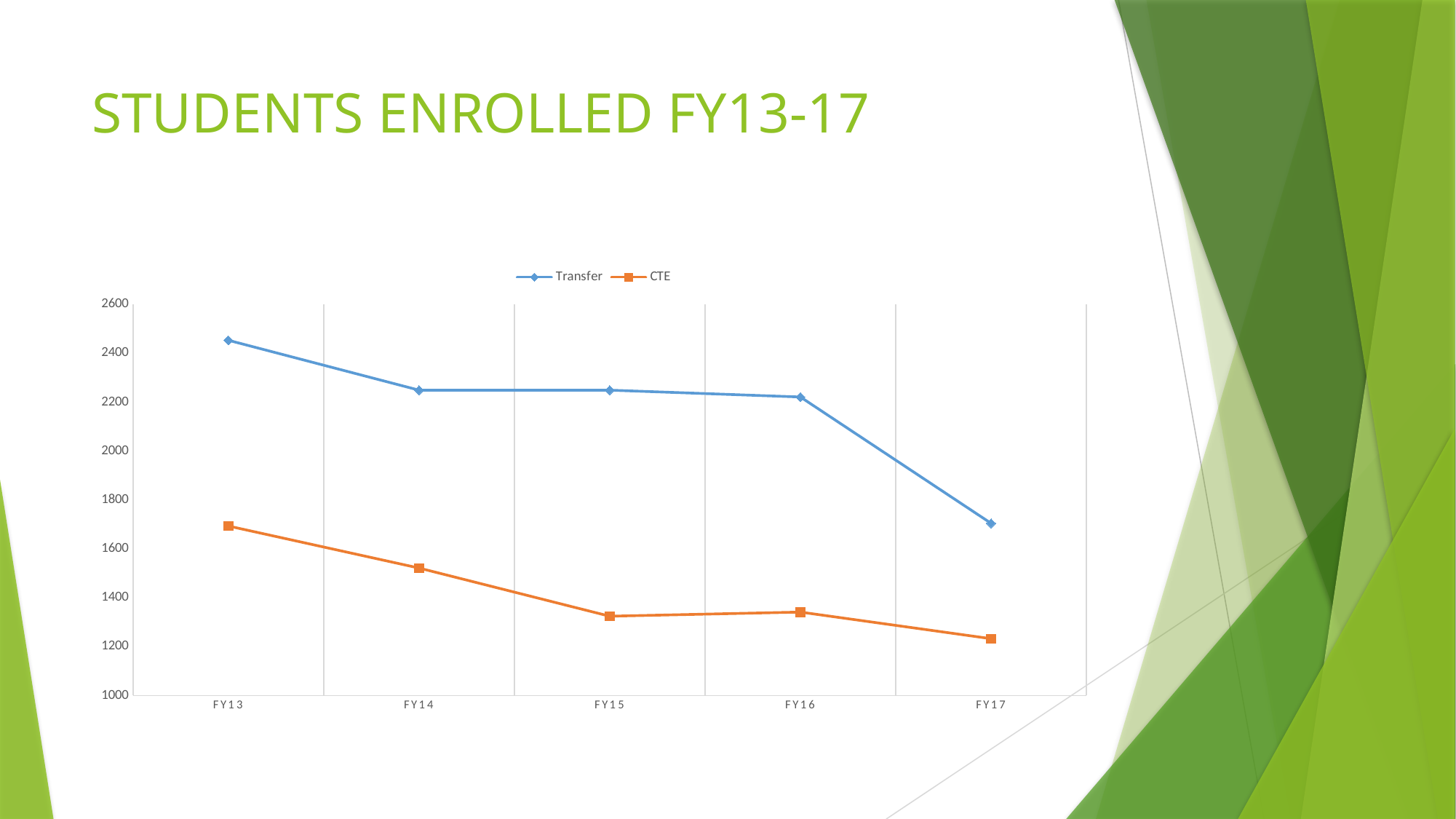
What kind of chart is shown on the slide? line chart In which fiscal year is the Transfer enrollment highest? FY13 Is the Transfer value for FY17 greater or less than 1800? less Is the CTE value for FY13 greater or less than 1600? greater How many fiscal years are plotted on the x axis? 5 In which fiscal year is the Transfer enrollment lowest? FY17 How many series does the legend list? 2 Is the CTE value for FY15 greater or less than 1400? less Does the Transfer enrollment rise or fall from FY13 to FY17? fall Which series has the larger value in FY15, Transfer or CTE? Transfer In which fiscal year is the CTE enrollment lowest? FY17